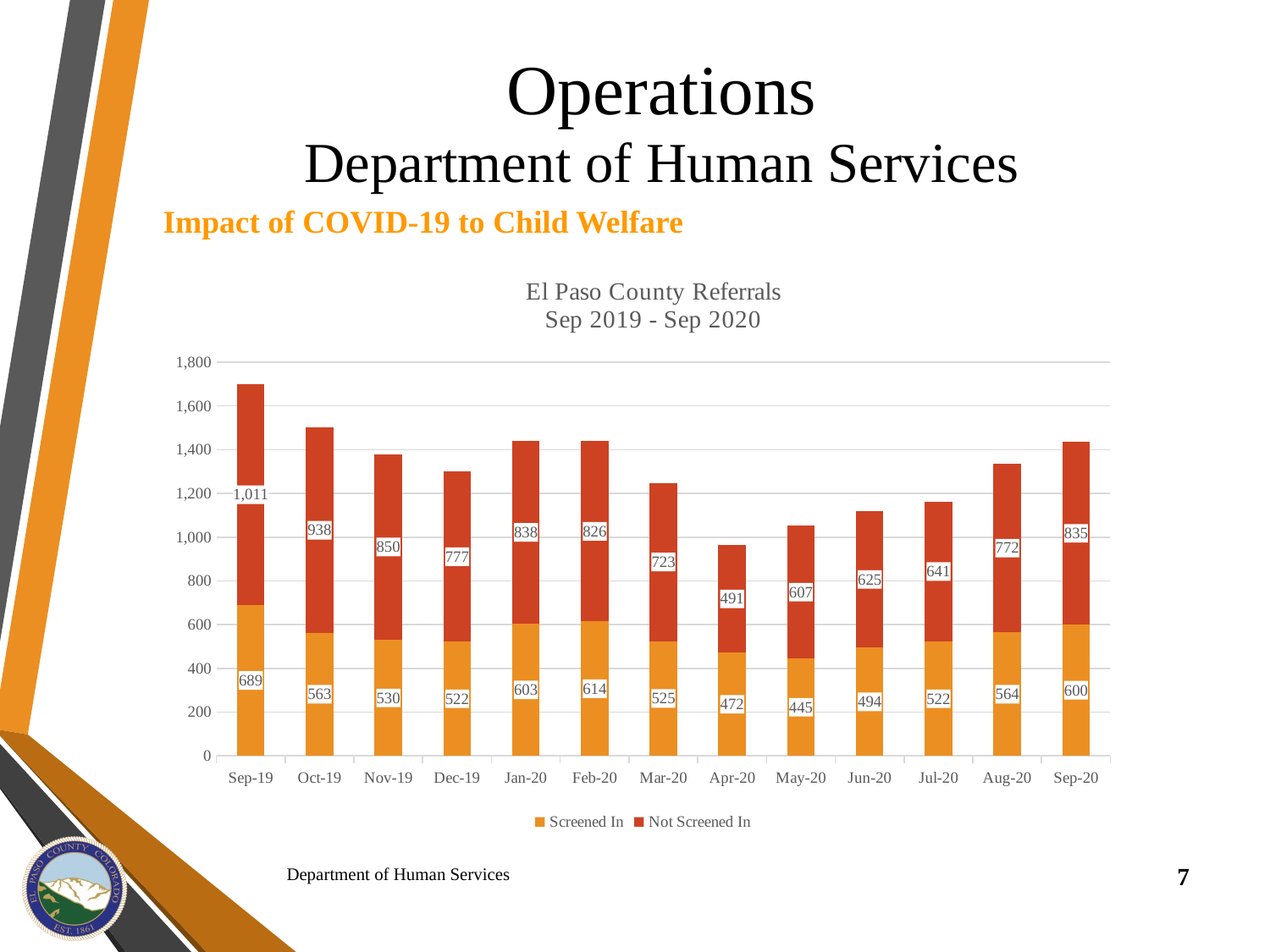
Which month has the highest Not Screened In value? Sep-19 What is the Not Screened In value for Sep-19? 1,011 What is the Screened In value for Apr-20? 472 Which is larger, the Not Screened In value for Oct-19 or for Nov-19? Oct-19 How many months are shown on the x axis? 13 What is the total of the stacked bar for Sep-19? 1,700 Which month has the lowest Screened In value? May-20 What is the difference between the Screened In values for Sep-19 and Sep-20? 89 What is the Not Screened In value for Jul-20? 641 What kind of chart is shown on the slide? Stacked bar chart How many series does the legend list? 2 What is the total of the stacked bar for Apr-20? 963